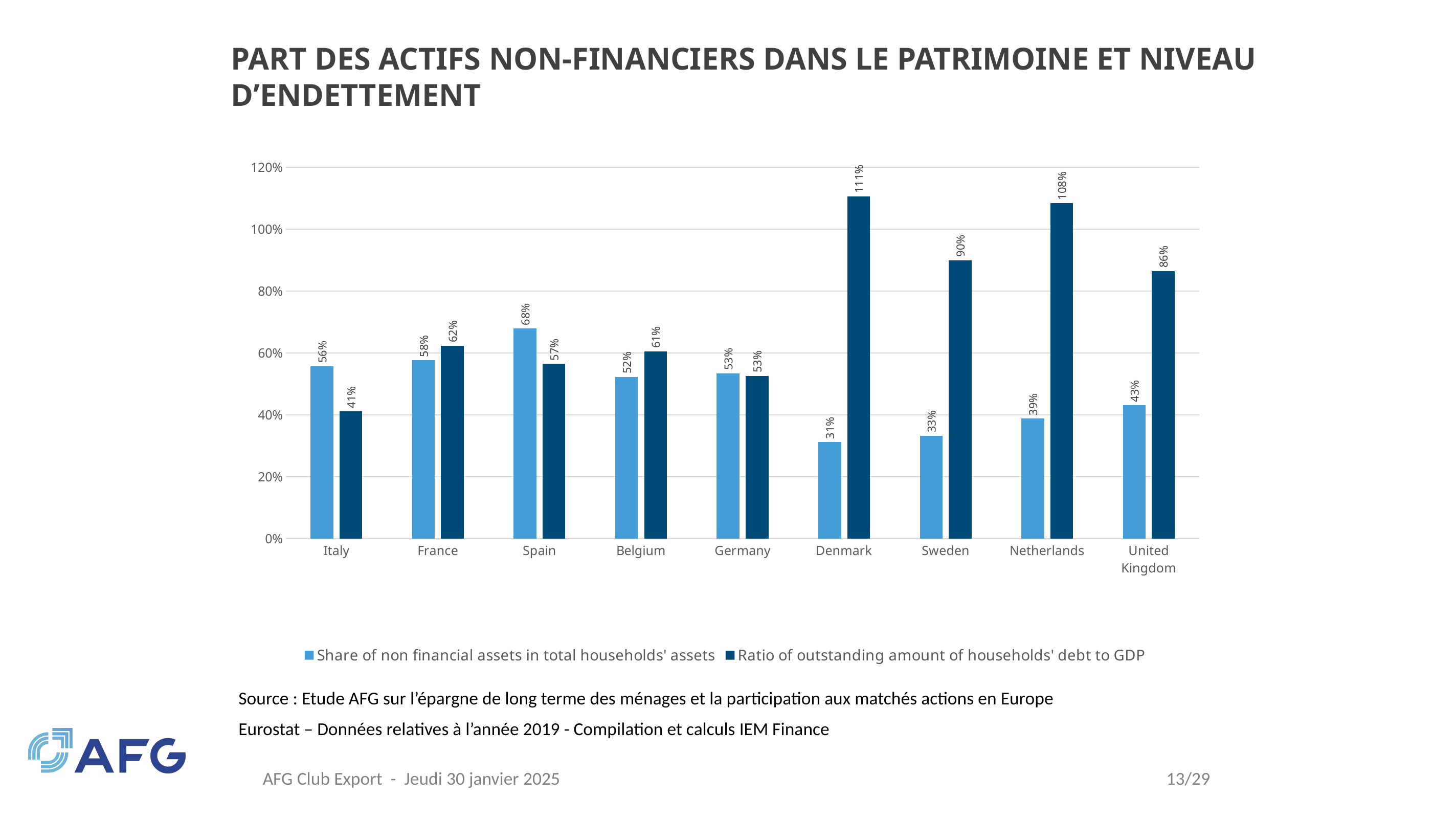
What is the difference between the ratio of households' debt to GDP and the share of non financial assets for the Netherlands? 69% Which country has the highest ratio of outstanding amount of households' debt to GDP? Denmark What kind of chart is shown on the slide? Bar chart What is the ratio of outstanding amount of households' debt to GDP for Italy? 41% Which is larger for France: the share of non financial assets in total households' assets or the ratio of households' debt to GDP? Ratio of outstanding amount of households' debt to GDP What is the ratio of outstanding amount of households' debt to GDP for Denmark? 111% Which colour represents the ratio of outstanding amount of households' debt to GDP? Dark blue Which country has the highest share of non financial assets in total households' assets? Spain How many series does the legend list? 2 Which country has the lowest share of non financial assets in total households' assets? Denmark What is the share of non financial assets in total households' assets for Spain? 68% How many countries are shown on the x axis? 9